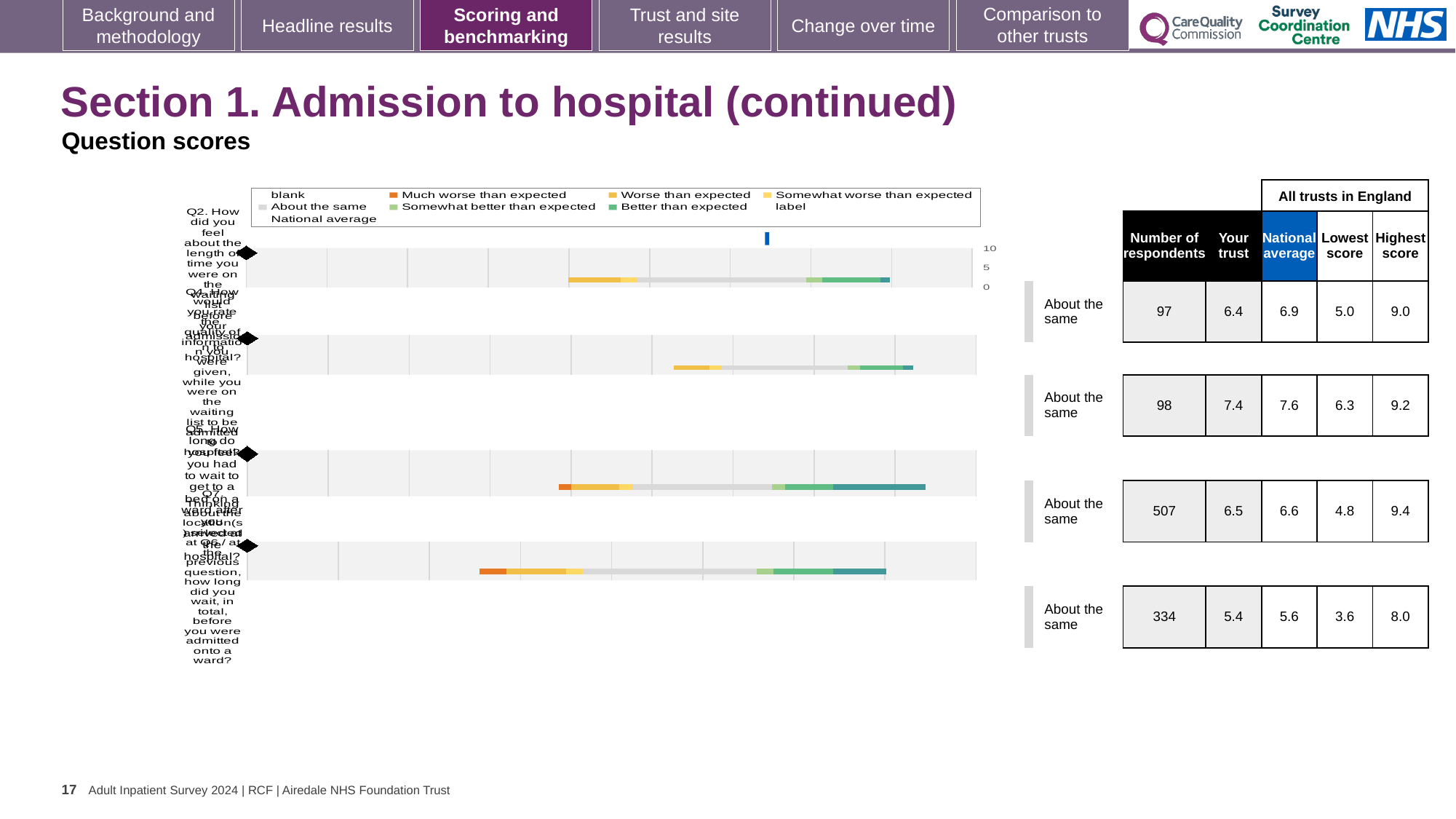
In the table, what is the number of respondents for the first (top) question row? 97 In the table, what is the highest score for the fourth (bottom) question row? 8.0 What benchmark category label is shown next to each of the four question rows? About the same For the first question row, what is the difference between the national average and the 'Your trust' score? 0.5 In the table, what is the lowest score for the second question row? 6.3 Which question row has the lowest 'Your trust' score in the table? the fourth row (5.4) How many question rows are shown in the chart and table? 4 In the table, what is the 'Your trust' score for the second question row? 7.4 Which question row has the highest number of respondents in the table? the third row (507) For the second question row, is the 'Your trust' score higher or lower than the national average? lower In the table, what is the national average for the third question row? 6.6 What kind of chart is shown on the left of the slide? bar chart